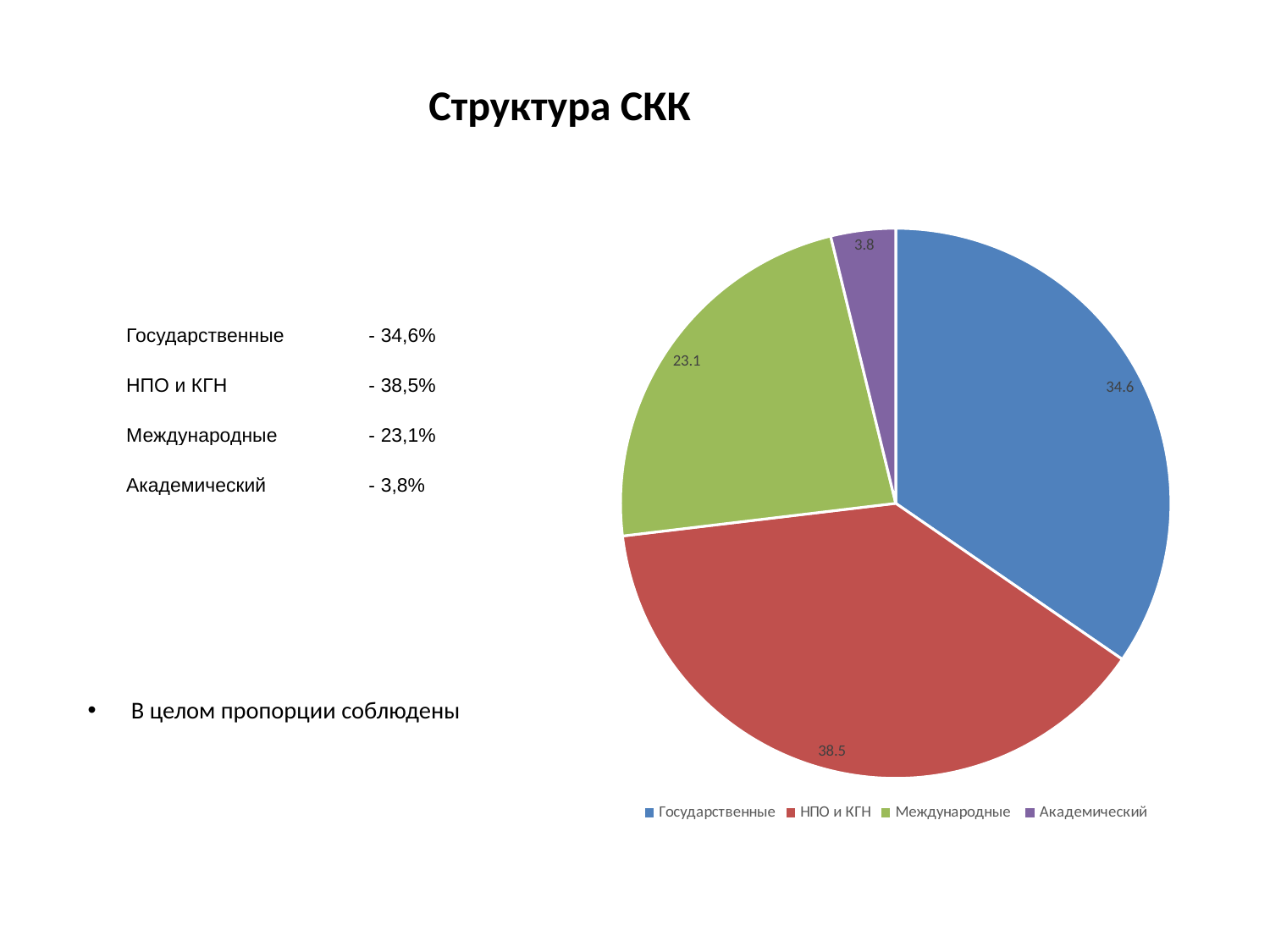
How many entries does the legend list? 4 What kind of chart is shown on the slide? pie chart What colour is the slice for Международные? green What is the value shown for Государственные in the pie chart? 34.6 Which category has the largest slice in the pie chart? НПО и КГН How many slices does the pie chart have? 4 What is the value shown for Международные in the pie chart? 23.1 What is the value shown for Академический in the pie chart? 3.8 Which category has the smallest slice in the pie chart? Академический What is the value shown for НПО и КГН in the pie chart? 38.5 What is the difference between the values for НПО и КГН and Государственные? 3.9 Which is larger, the slice for Международные or the slice for Академический? Международные